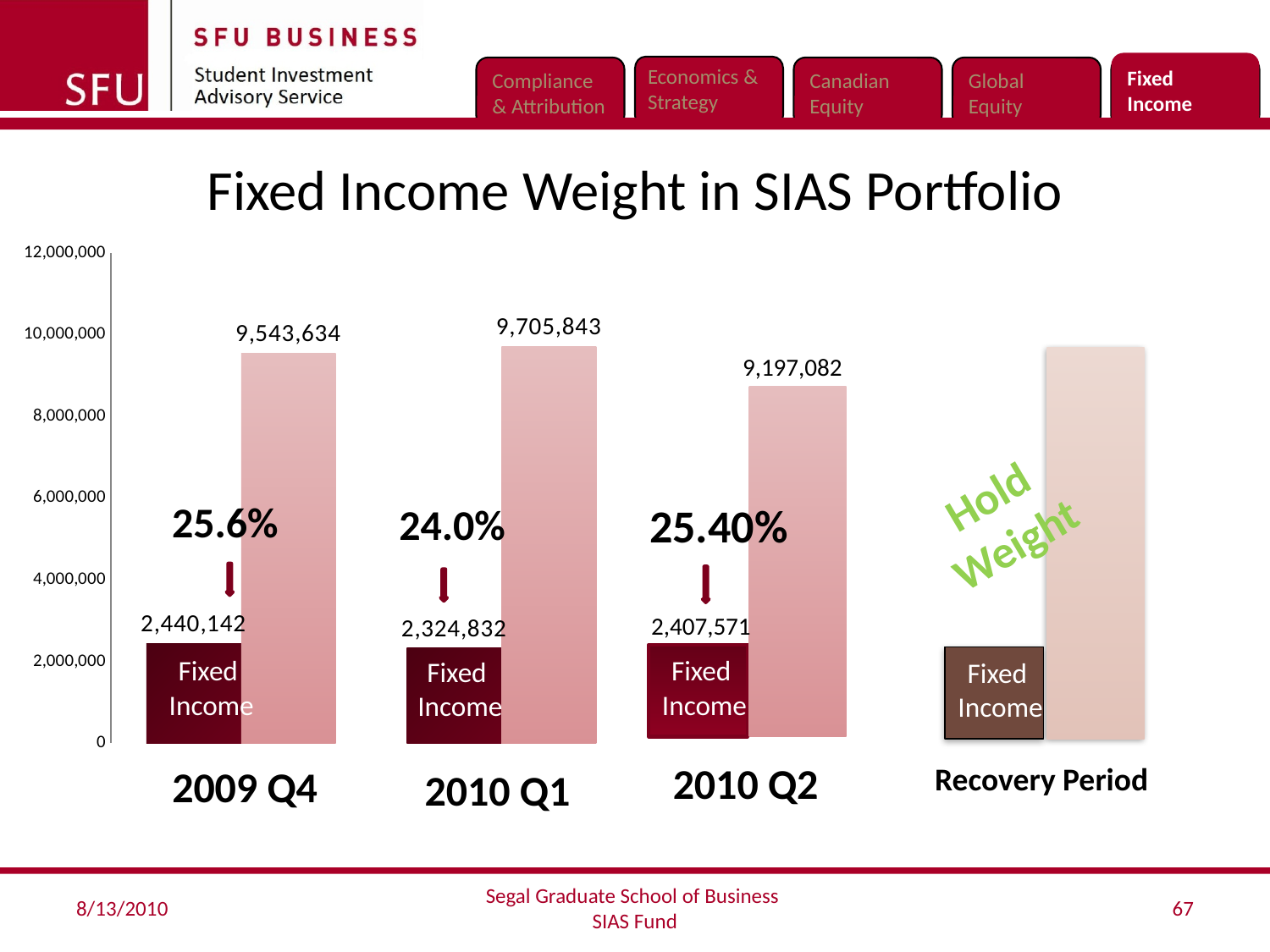
What is the Fixed Income value shown for 2010 Q1? 2,324,832 What is the difference between the total portfolio values for 2010 Q1 and 2009 Q4? 162,209 What kind of chart is shown on the slide? bar chart What is the title of the chart? Fixed Income Weight in SIAS Portfolio Which is larger, the total portfolio value for 2009 Q4 or for 2010 Q2? 2009 Q4 Is the total portfolio value for 2010 Q2 greater or less than 10,000,000? less Which quarter has the highest total portfolio value? 2010 Q1 How many quarters have labelled values in the chart? 3 Which quarter has the lowest Fixed Income value? 2010 Q1 What is the total portfolio value shown for 2009 Q4? 9,543,634 What is the difference between the Fixed Income values for 2009 Q4 and 2010 Q2? 32,571 What Fixed Income weight percentage is shown for 2010 Q2? 25.40%